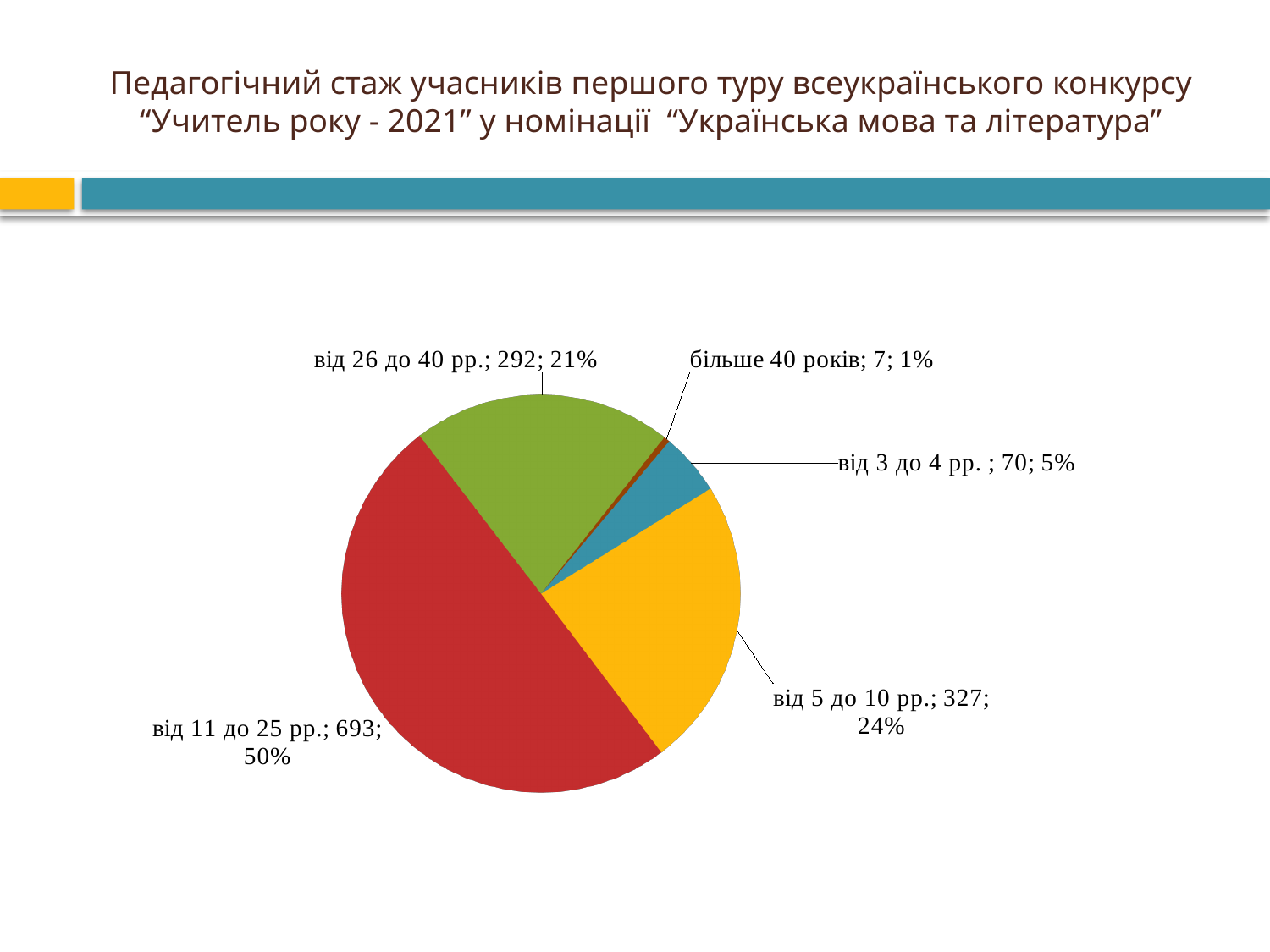
What share of the pie does the slice "від 3 до 4 рр." represent? 5% What share of the pie does the slice "від 26 до 40 рр." represent? 21% What kind of chart is shown on the slide? pie chart Which is larger, the value for "від 5 до 10 рр." or the value for "від 26 до 40 рр."? від 5 до 10 рр. What is the value for the slice "від 26 до 40 рр."? 292 What is the value for the slice "від 11 до 25 рр."? 693 Which slice is the largest? від 11 до 25 рр. What is the difference between the values for "від 11 до 25 рр." and "від 5 до 10 рр."? 366 Which slice is the smallest? більше 40 років What is the value for the slice "від 5 до 10 рр."? 327 How many slices does the pie chart have? 5 What is the value for the slice "більше 40 років"? 7